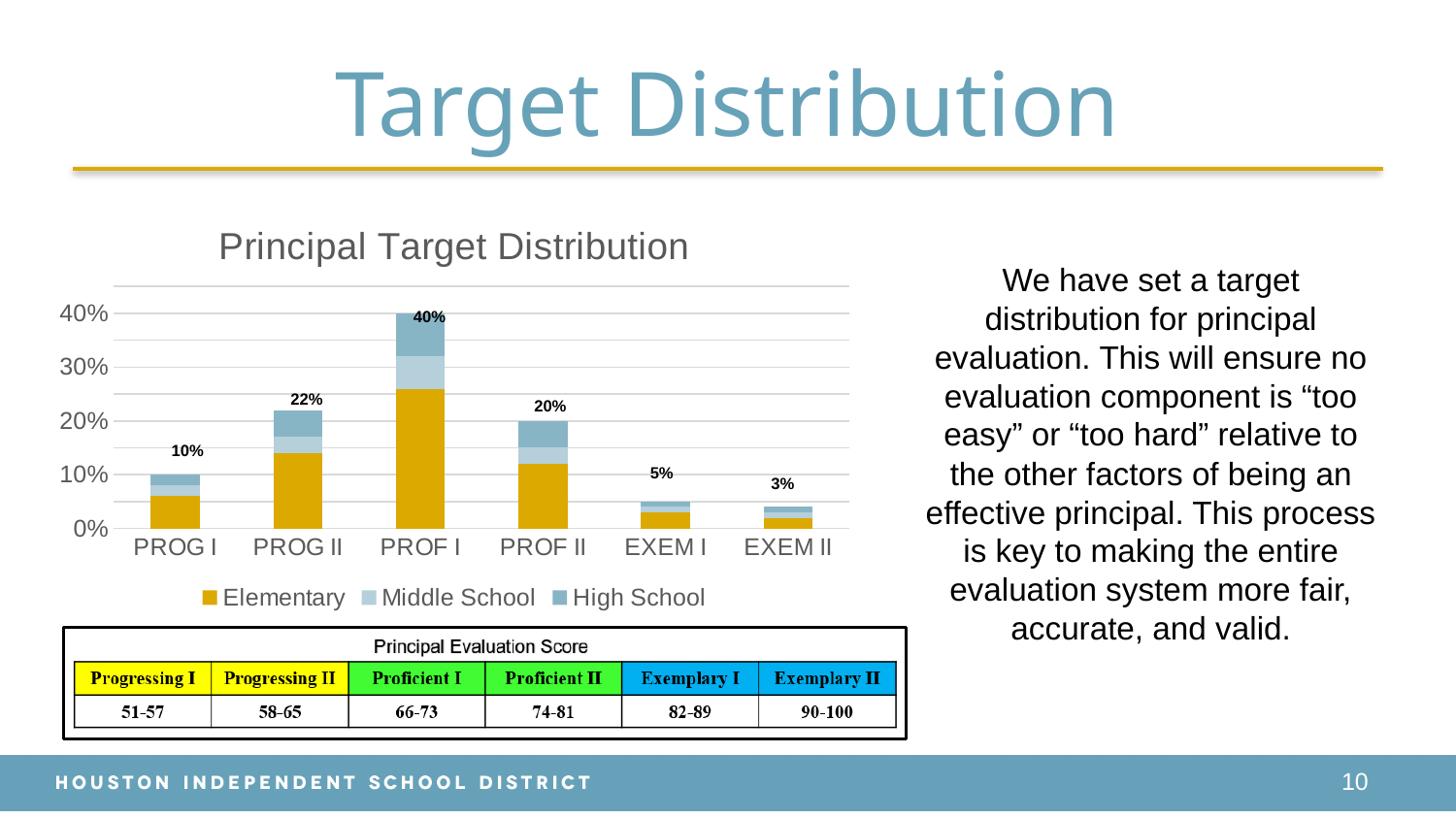
Which has a larger total, PROG II or PROF II? PROG II What is the total target percentage for the PROG II bar? 22% What is the difference between the total for PROF I and the total for PROF II? 20% Is the Elementary value for PROF I greater or less than 20%? greater What kind of chart is shown? Stacked bar chart What is the title of the chart? Principal Target Distribution How many series does the legend list? 3 What is the total target percentage for the PROF I bar? 40% Which category has the lowest total target percentage? EXEM II What is the total target percentage for the EXEM II bar? 3% How many categories are shown on the x axis? 6 Which category has the highest total target percentage? PROF I